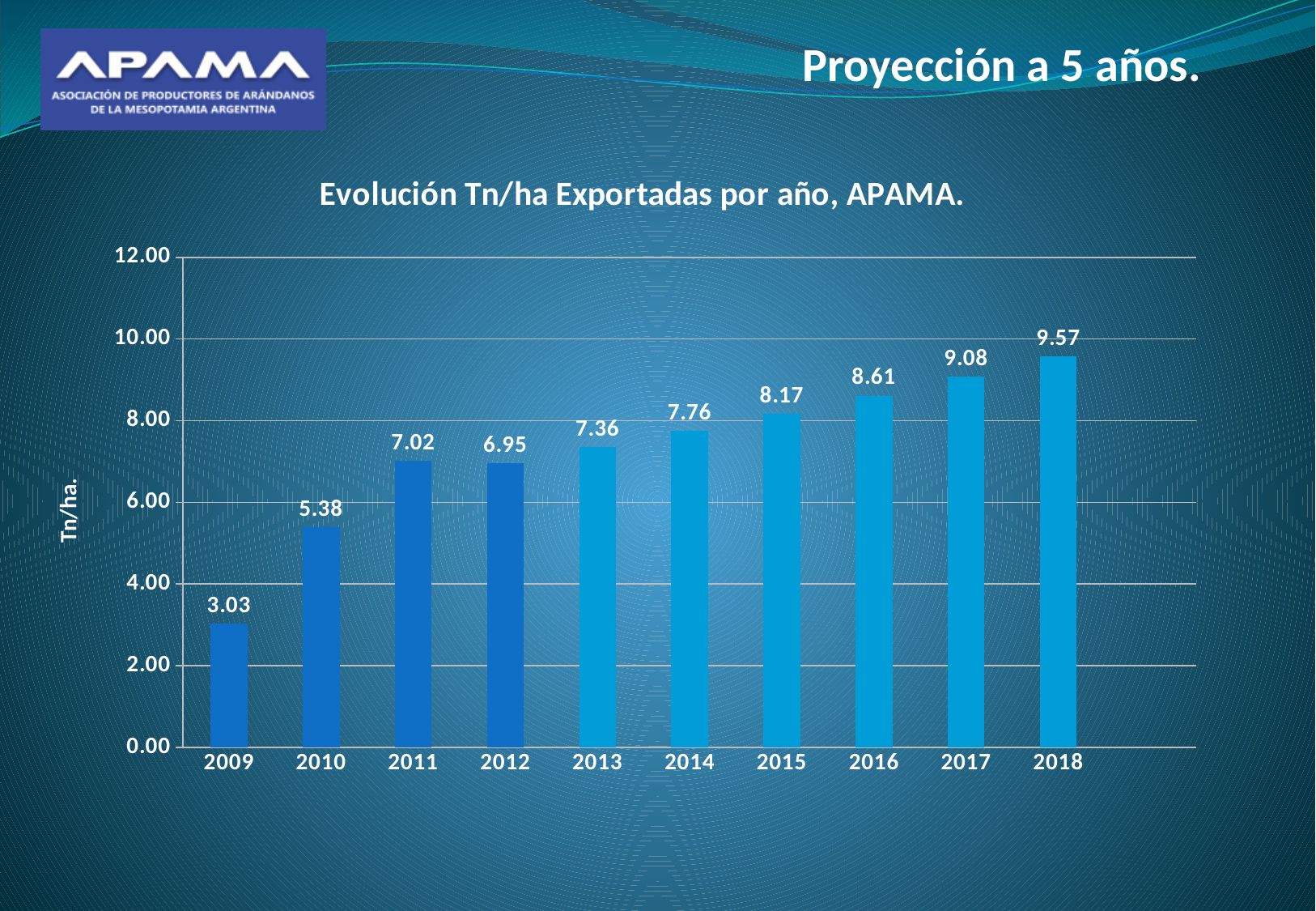
Which is larger, the value for 2010 or the value for 2013? 2013 What is the title of the chart? Evolución Tn/ha Exportadas por año, APAMA. How many years are shown on the x axis? 10 What is the value for 2018? 9.57 Which year has the highest value? 2018 Is the value for 2016 greater or less than 8.00? greater What is the value for 2009? 3.03 What is the difference between the values for 2011 and 2012? 0.07 What kind of chart is shown on the slide? bar chart What is the difference between the values for 2018 and 2009? 6.54 What is the value for 2014? 7.76 Which year has the lowest value? 2009